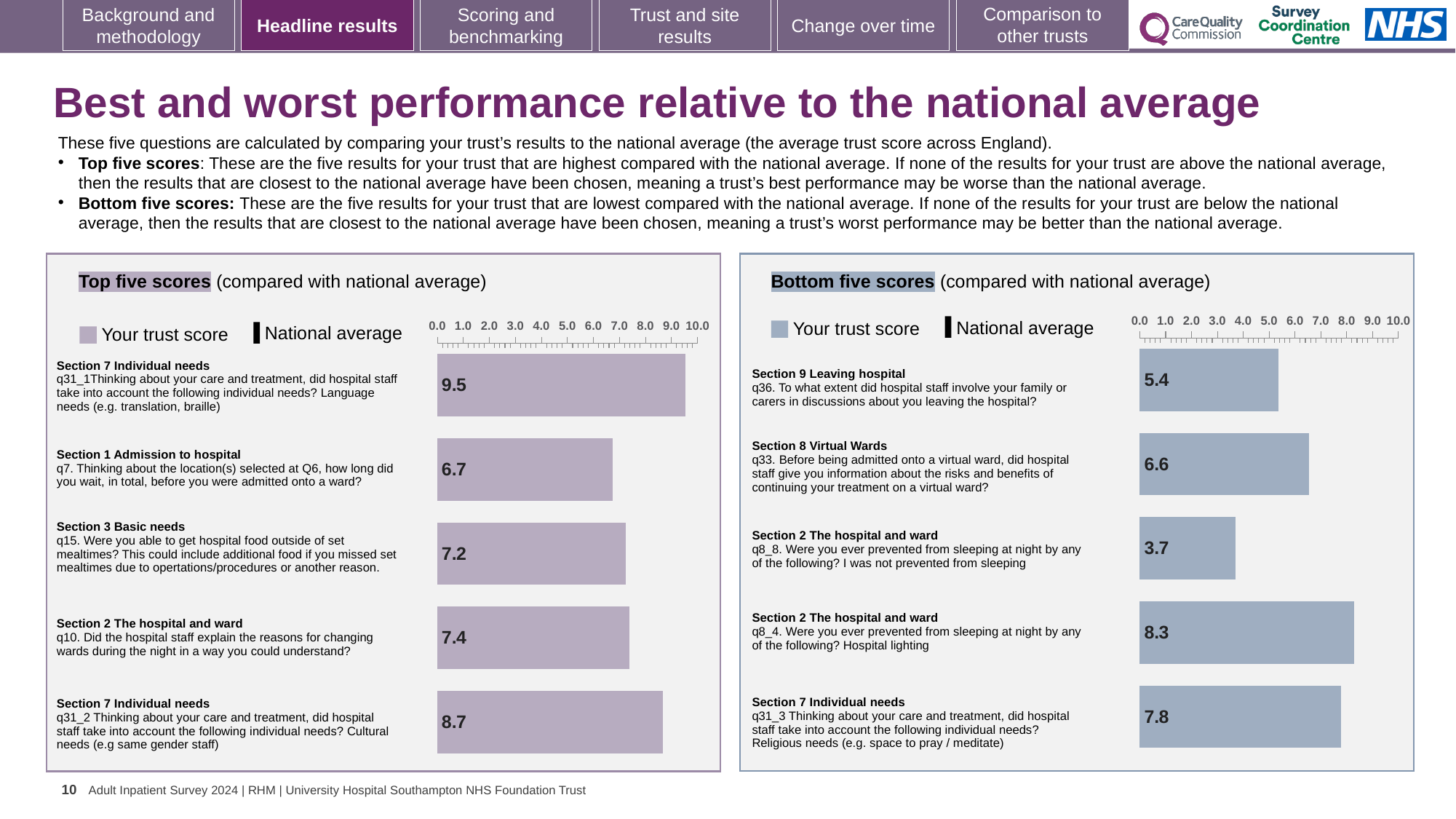
In the Top five scores chart, what is the difference between the trust scores for q31_1 (Language needs) and q31_2 (Cultural needs)? 0.8 In the Bottom five scores chart, what is the trust score for q36 (involving family or carers in discussions about leaving hospital)? 5.4 In the Top five scores chart, which has the larger trust score: q15 (food outside set mealtimes) or q10 (explaining reasons for changing wards)? q10 (explaining reasons for changing wards) What type of chart is the Top five scores chart? Bar chart In the Bottom five scores chart, what is the difference between the trust scores for q8_4 (Hospital lighting) and q8_8 (I was not prevented from sleeping)? 4.6 In the Top five scores chart, what is the trust score for q31_1 (Language needs)? 9.5 How many bars are shown in the Bottom five scores chart? 5 In the Top five scores chart, which question has the highest trust score? q31_1 (Language needs) In the Top five scores chart, what is the trust score for q7 (how long did you wait before being admitted onto a ward)? 6.7 In the Bottom five scores chart, which question has the lowest trust score? q8_8 (I was not prevented from sleeping) In the Bottom five scores chart, which question has the highest trust score? q8_4 (Hospital lighting) In the Bottom five scores chart, what is the trust score for q8_8 (I was not prevented from sleeping)? 3.7